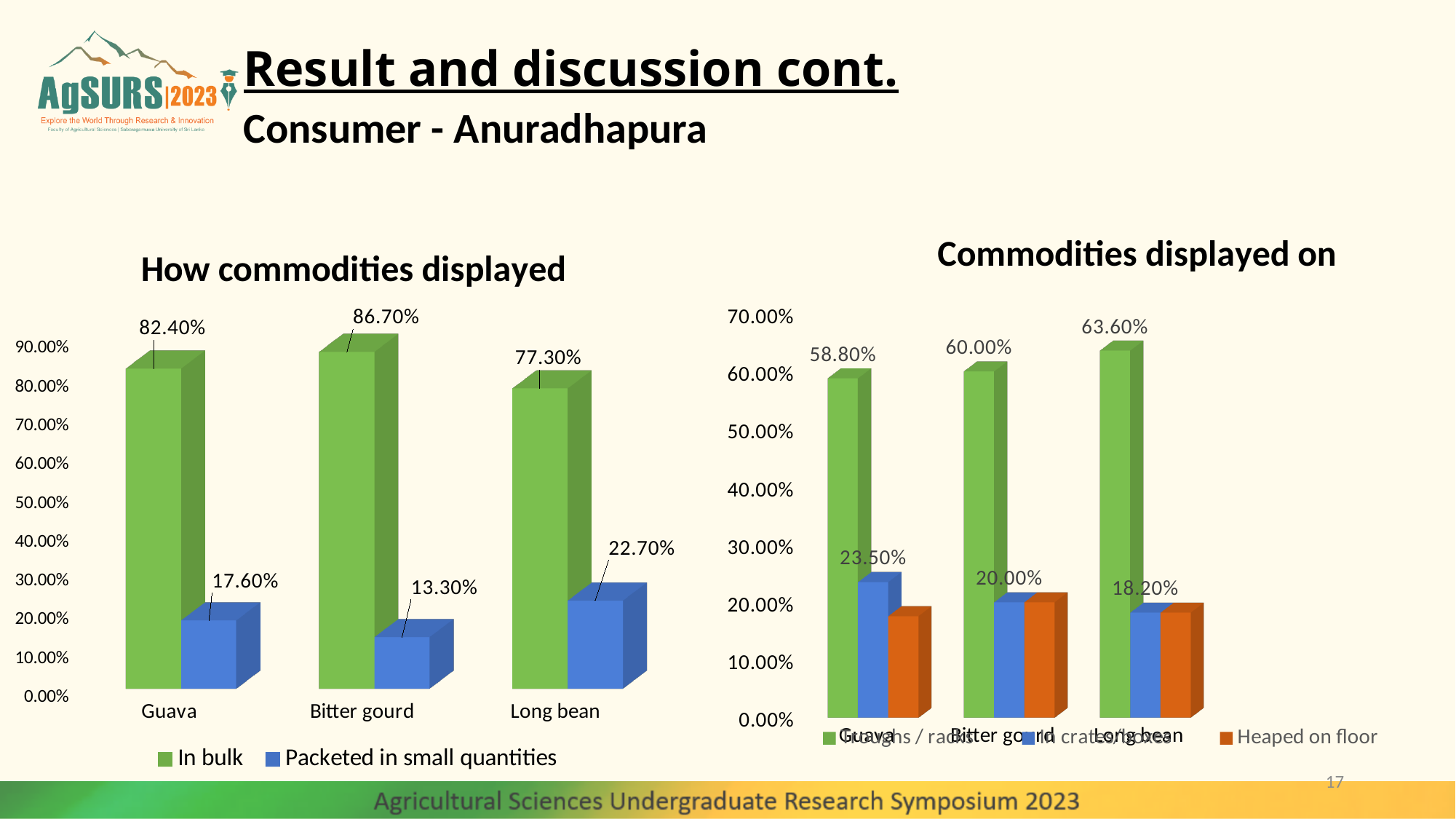
In the 'How commodities displayed' chart, which commodity has the lowest 'Packeted in small quantities' value? Bitter gourd In the 'How commodities displayed' chart, which is larger: the 'Packeted in small quantities' value for Guava or for Long bean? Long bean In the 'How commodities displayed' chart, what is the 'Packeted in small quantities' value for Long bean? 22.70% In the 'Commodities displayed on' chart, is the 'Heaped on floor' value for Guava greater or less than 30.00%? less How many series does the legend of the 'How commodities displayed' chart list? 2 In the 'Commodities displayed on' chart, what is the 'In crates/boxes' value for Guava? 23.50% In the 'Commodities displayed on' chart, what is the 'Troughs / racks' value for Long bean? 63.60% How many commodity categories are shown on the x axis of the 'Commodities displayed on' chart? 3 What kind of chart is the 'Commodities displayed on' chart? Bar chart In the 'How commodities displayed' chart, which commodity has the highest 'In bulk' value? Bitter gourd In the 'How commodities displayed' chart, what is the difference between the 'In bulk' and 'Packeted in small quantities' values for Guava? 64.80% In the 'How commodities displayed' chart, what is the 'In bulk' value for Bitter gourd? 86.70%